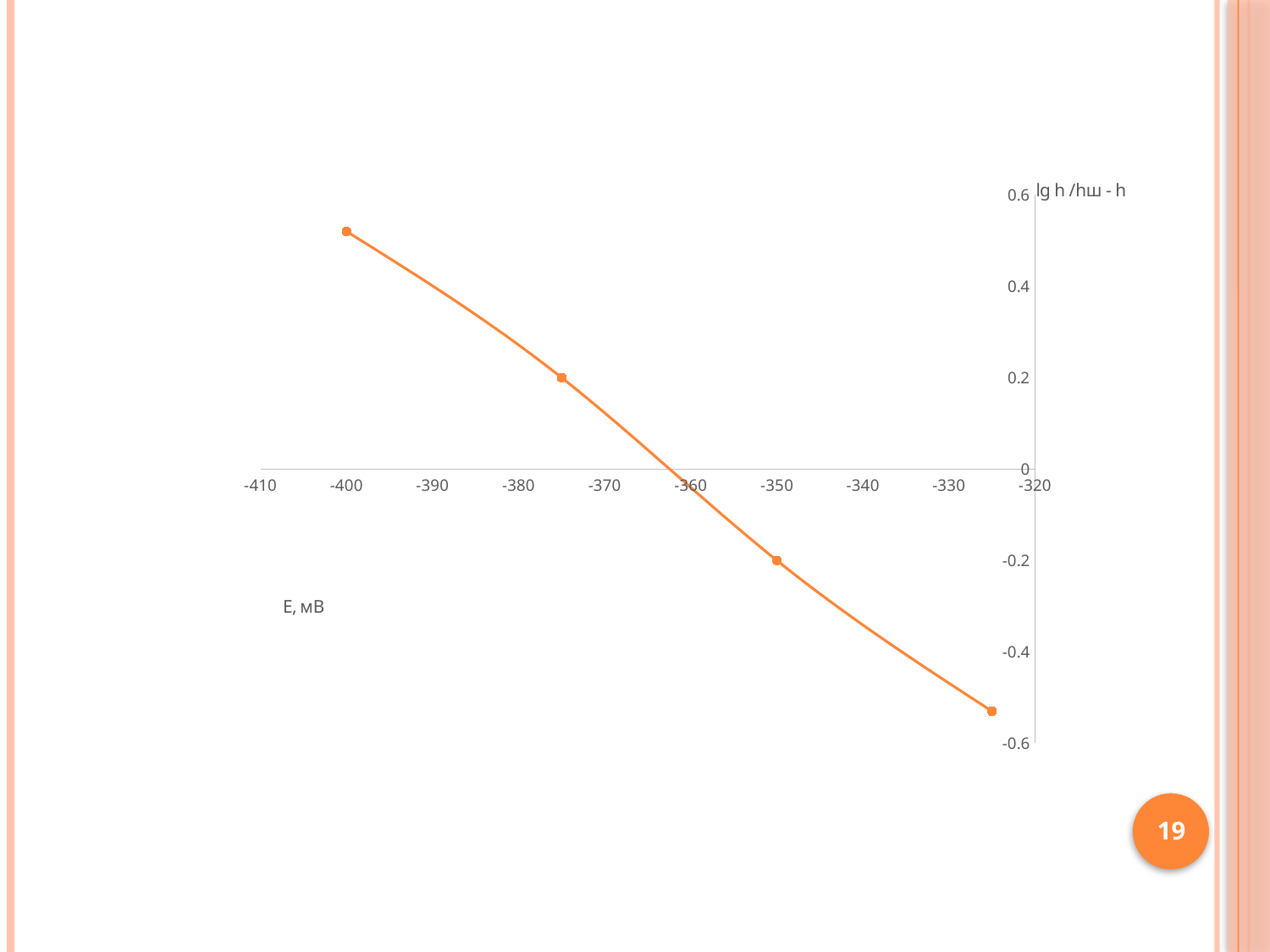
At which E value does the chart reach its highest lg h/hш - h value? -400 What is the label of the horizontal axis? E, мВ Is the value of the rightmost point greater or less than -0.4? less Do the plotted values rise or fall as E increases along the x axis? fall How many data points are plotted on the chart? 4 Which point has the larger value: the point at E = -400 мВ or the point at E = -350 мВ? the point at E = -400 мВ What kind of chart is shown on the slide? line chart What is the label of the vertical axis? lg h /hш - h Is the value of the leftmost point (at E = -400 мВ) greater or less than 0.4? greater What is the value of lg h/hш - h at E = -350 мВ? -0.2 Is the value of the second point from the left greater or less than 0? greater